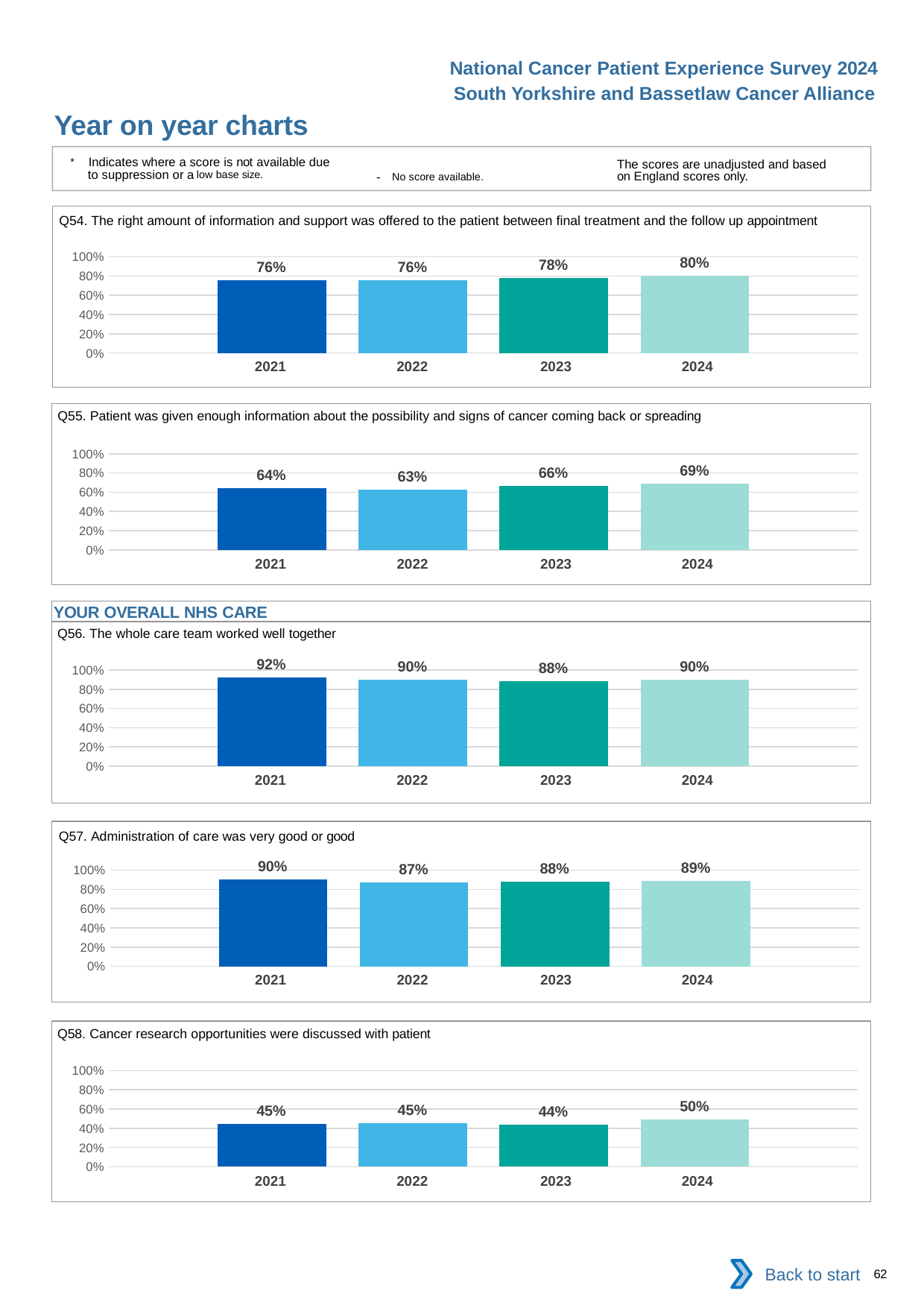
In the Q55 chart, which year has the lowest value? 2022 What kind of chart is the Q58 chart? Bar chart In the Q58 chart, which year has the lowest value? 2023 In the Q54 chart, what is the value for 2024? 80% How many years are shown on the x axis of the Q54 chart? 4 In the Q56 chart, what is the value for 2023? 88% In the Q55 chart, what is the difference between the 2024 and 2021 values? 5% In the Q58 chart, what is the value for 2024? 50% In the Q57 chart, which is larger, the value for 2022 or the value for 2024? 2024 In the Q56 chart, which year has the highest value? 2021 In the Q57 chart, what is the value for 2021? 90% In the Q54 chart, do the values rise or fall from 2022 to 2024? Rise